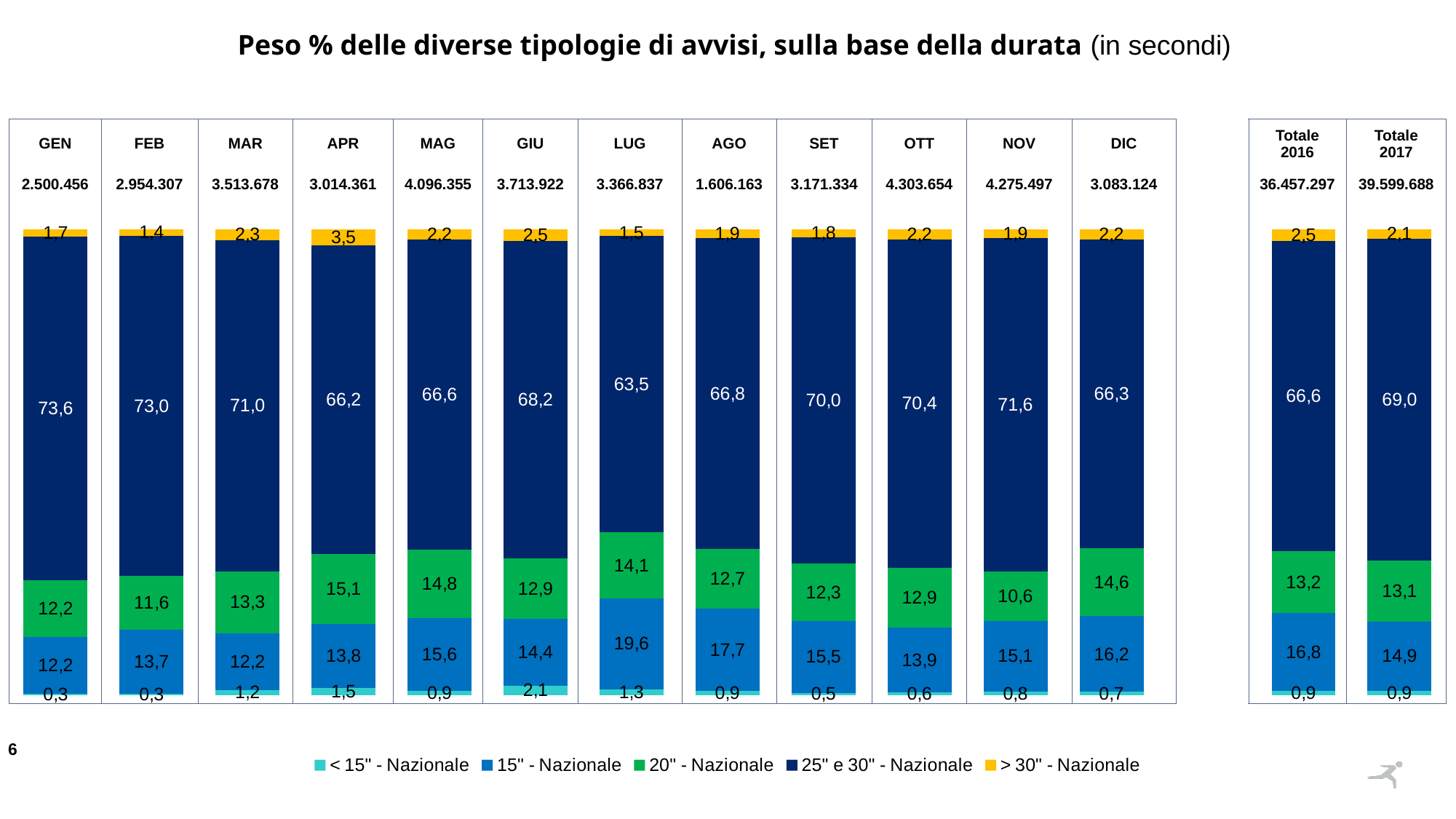
What is the value of the 15" - Nazionale series for LUG? 19,6 What is the value of the > 30" - Nazionale series for APR? 3,5 What is the value of the < 15" - Nazionale series for GIU? 2,1 Which is larger, the 20" - Nazionale value for APR or for MAG? APR How many series does the legend list? 5 Which month has the highest value for the 25" e 30" - Nazionale series? GEN What is the value of the 25" e 30" - Nazionale series for GEN? 73,6 What kind of chart is shown on the slide? Stacked bar chart Which month has the lowest value for the 25" e 30" - Nazionale series? LUG Which month has the highest value for the > 30" - Nazionale series? APR How many monthly bars (excluding the two totals) are shown in the chart? 12 What is the difference between the 25" e 30" - Nazionale values for Totale 2017 and Totale 2016? 2,4